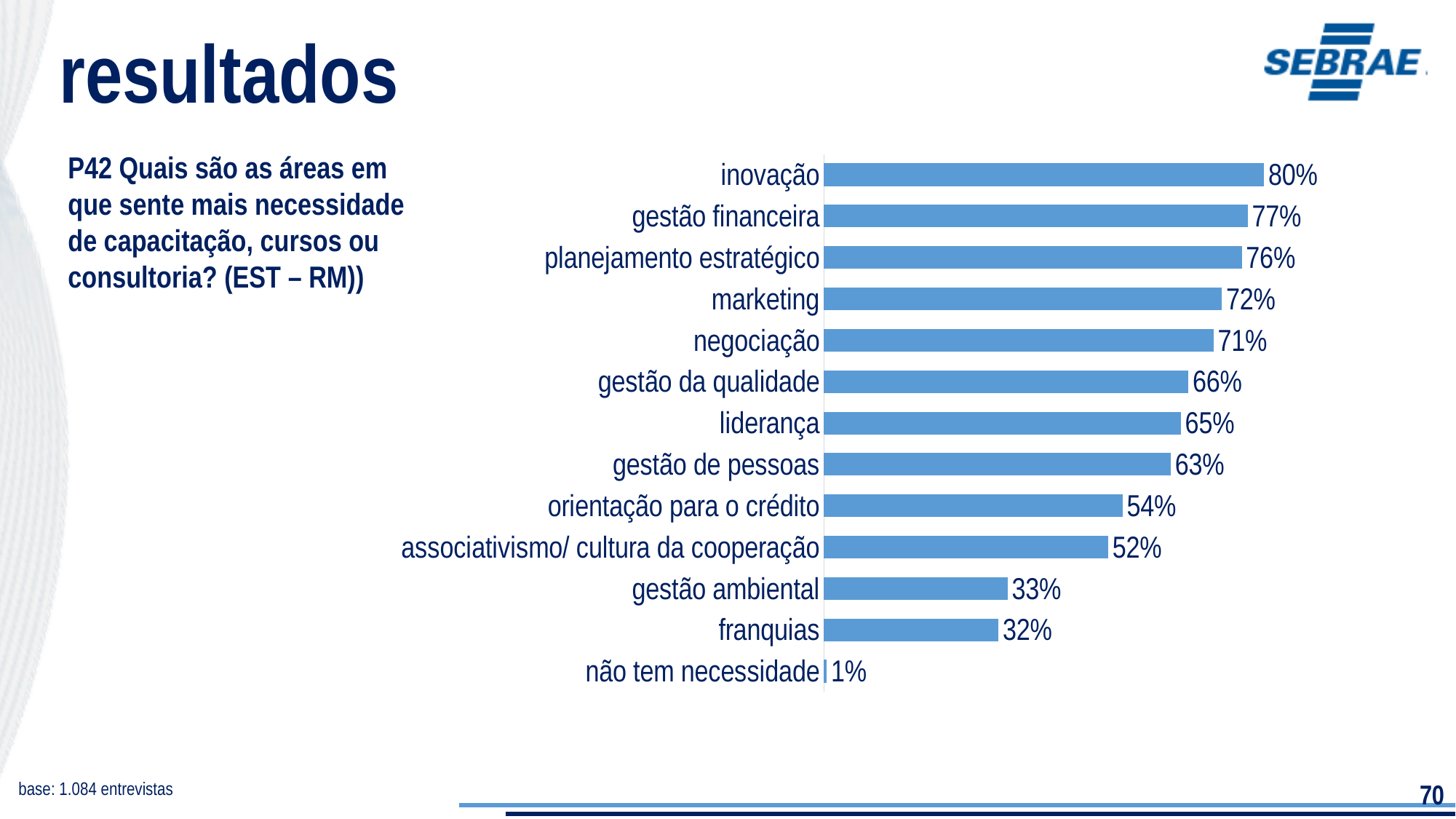
How many categories are shown in the chart? 13 What is the base (number of interviews) stated on the slide? 1.084 entrevistas Which is larger, the value for liderança or the value for gestão de pessoas? liderança What kind of chart is shown on the slide? bar chart What is the difference between the values for inovação and marketing? 8% What is the value for inovação? 80% What is the value for franquias? 32% Which category has the lowest value? não tem necessidade What is the difference between the values for gestão ambiental and franquias? 1% What is the value for orientação para o crédito? 54% Which category has the highest value? inovação What is the value for gestão financeira? 77%